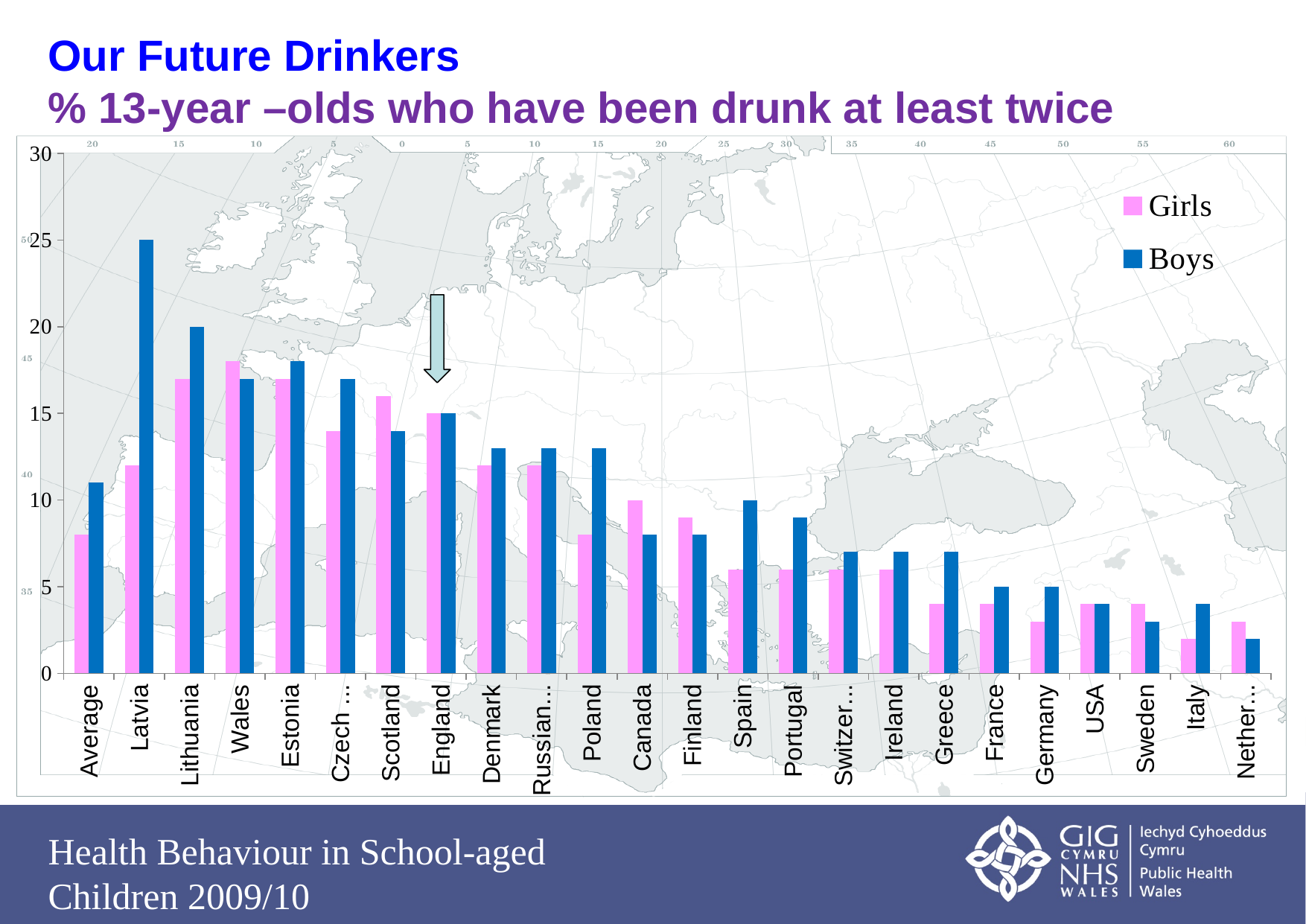
What kind of chart is shown on the slide? bar chart Which category has the lowest value for Girls? Italy Which category has the lowest value for Boys? Netherlands Which category has the highest value for Boys? Latvia Is the value for Boys in the Average category greater or less than 10? greater How many series does the legend list? 2 Which colour represents Boys in the chart? blue What is the value for Boys in Lithuania? 20 How many countries/categories are shown along the x axis? 24 Is the value for Girls in Italy greater or less than 5? less In Scotland, which is larger, the value for Girls or the value for Boys? Girls What is the value for Boys in Latvia? 25